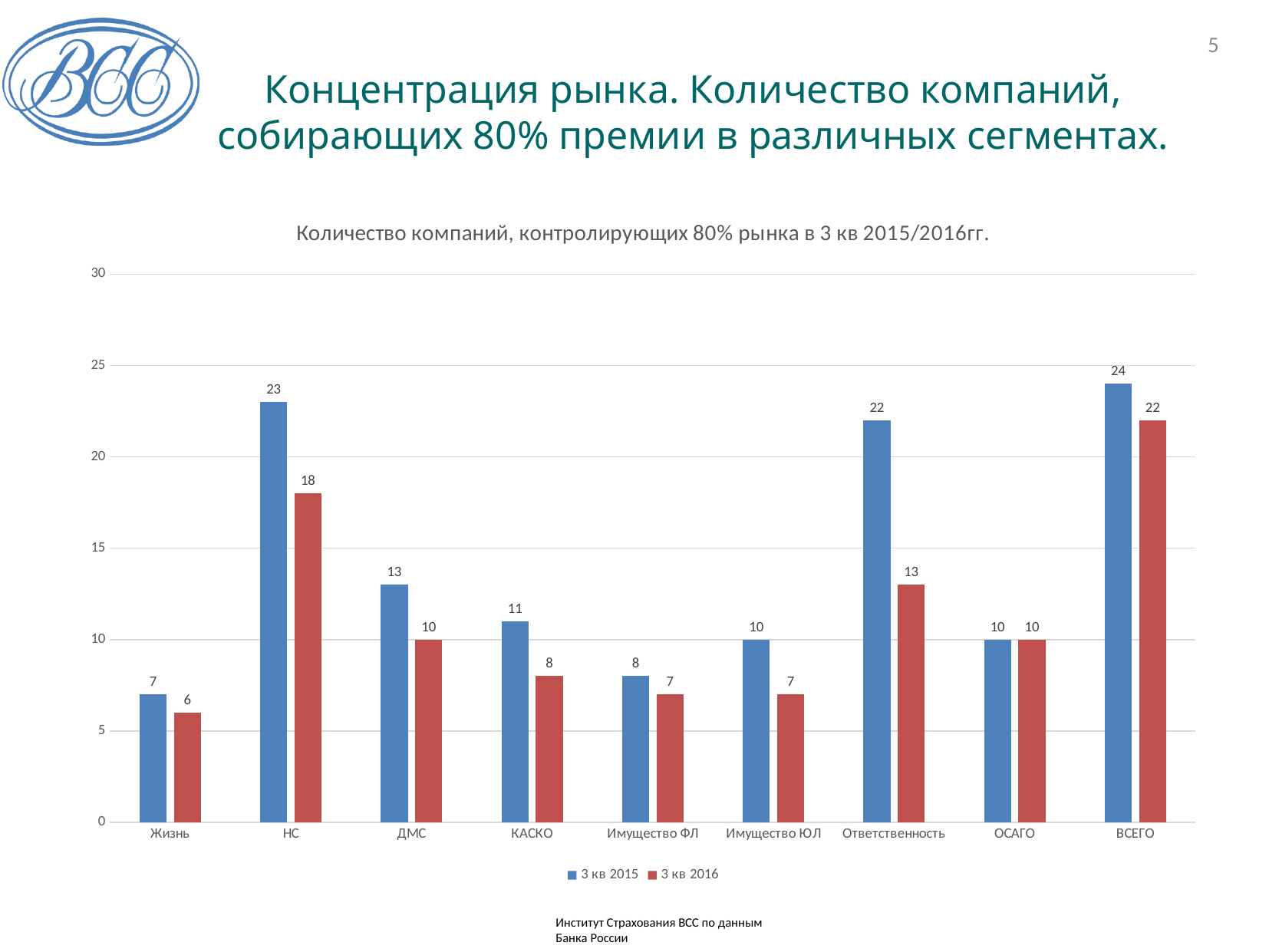
What kind of chart is shown on the slide? bar chart How many series does the legend list? 2 How many categories are shown on the x axis? 9 Is the value for ДМС in the 3 кв 2015 series greater or less than 10? greater What is the value for Имущество ЮЛ in the 3 кв 2015 series? 10 Which category has the highest value in the 3 кв 2016 series? ВСЕГО What is the value for Ответственность in the 3 кв 2016 series? 13 Which category has the lowest value in the 3 кв 2015 series? Жизнь What is the value for НС in the 3 кв 2015 series? 23 Which is larger for КАСКО: the 3 кв 2015 value or the 3 кв 2016 value? 3 кв 2015 What is the difference between the 3 кв 2015 and 3 кв 2016 values for НС? 5 What is the title of the chart? Количество компаний, контролирующих 80% рынка в 3 кв 2015/2016гг.